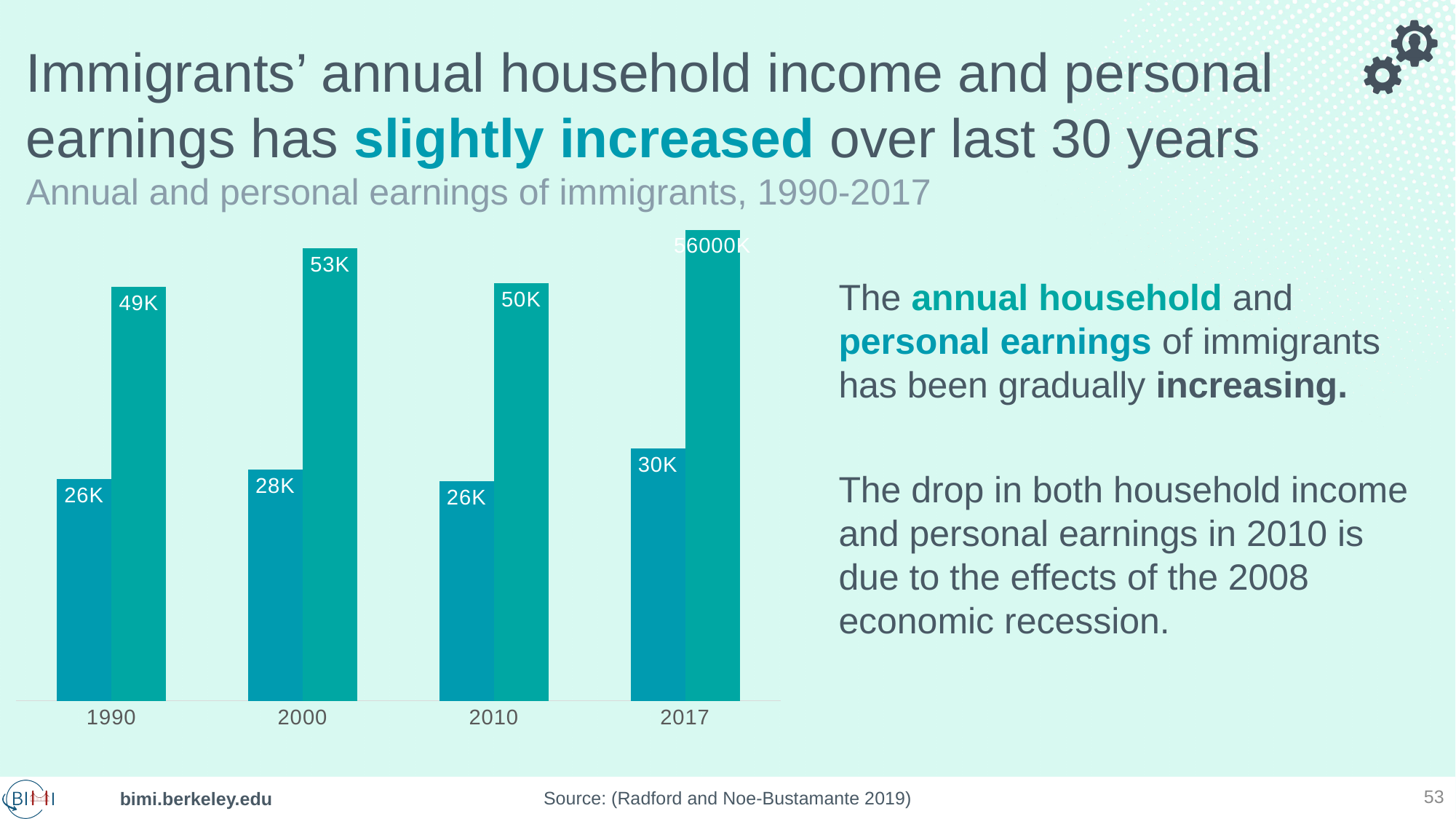
What is the value of the darker blue bar for 2017? 30K What is the value of the lighter teal bar for 2000? 53K What is the subtitle of the chart shown on the slide? Annual and personal earnings of immigrants, 1990-2017 Which year has the highest value for the darker blue bars? 2017 What is the difference between the lighter teal bar and the darker blue bar in 1990? 23K How many years are shown on the x axis of the chart? 4 What type of chart is shown on the slide? bar chart What is the value of the lighter teal bar for 2010? 50K What is the value of the darker blue bar for 1990? 26K What is the difference between the darker blue bar values for 2017 and 2010? 4K Which is larger, the lighter teal bar for 2000 or the lighter teal bar for 2010? 2000 Which year has the lowest value for the lighter teal bars? 1990